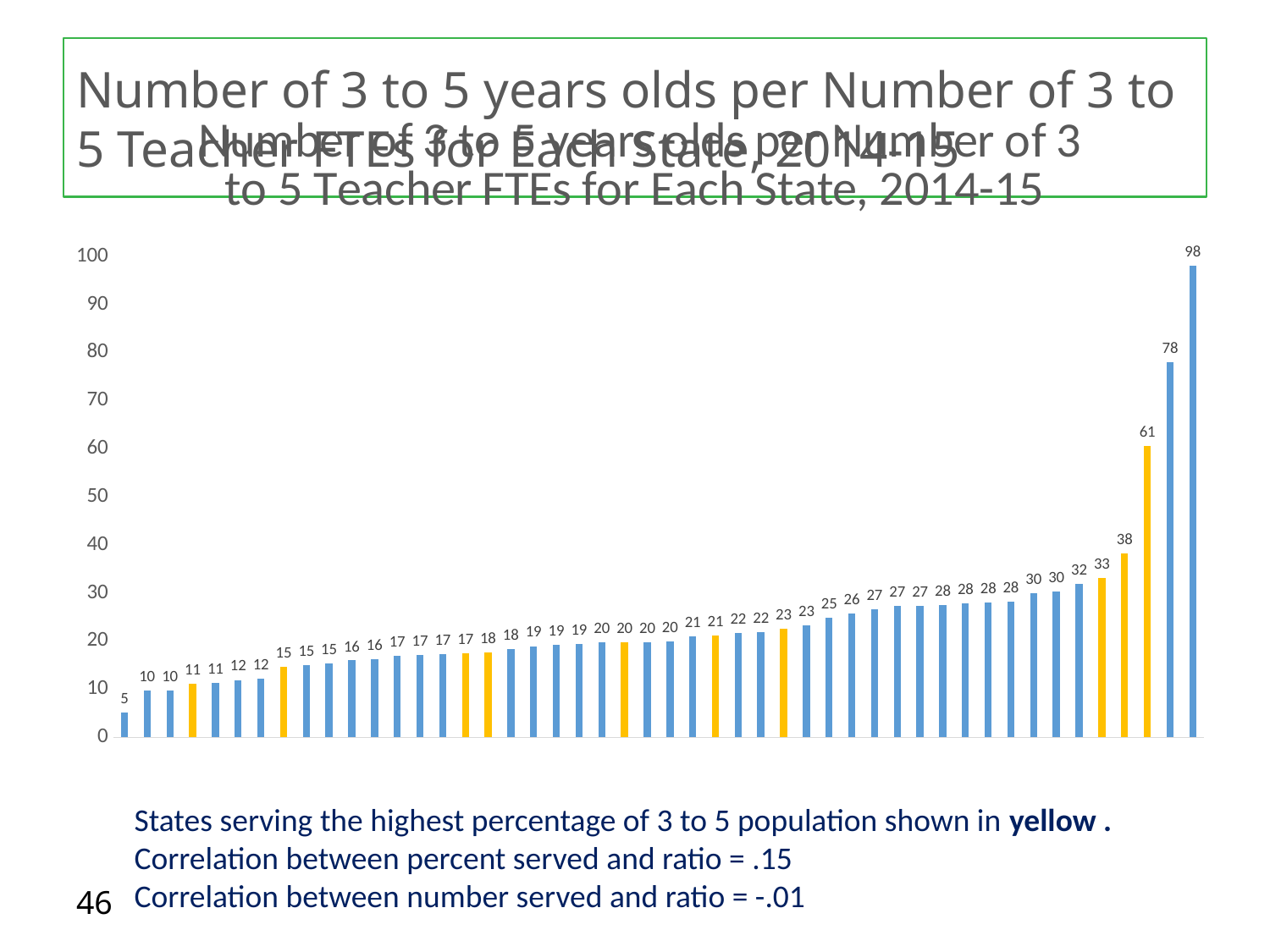
What is the value of the tallest yellow bar? 61 What is the difference between the lowest value (5) and the highest value (98)? 93 Which is larger, the tallest yellow bar or the tallest blue bar? the tallest blue bar What is the difference between the highest value (98) and the second highest value (78)? 20 What is the maximum value shown on the vertical axis? 100 What type of chart is shown on the slide? bar chart What is the value of the third tallest bar in the chart? 61 Do the bar values rise or fall from left to right along the x axis? rise According to the slide, what colour marks the states serving the highest percentage of the 3 to 5 population? yellow What is the highest value shown in the chart? 98 What is the lowest value shown in the chart? 5